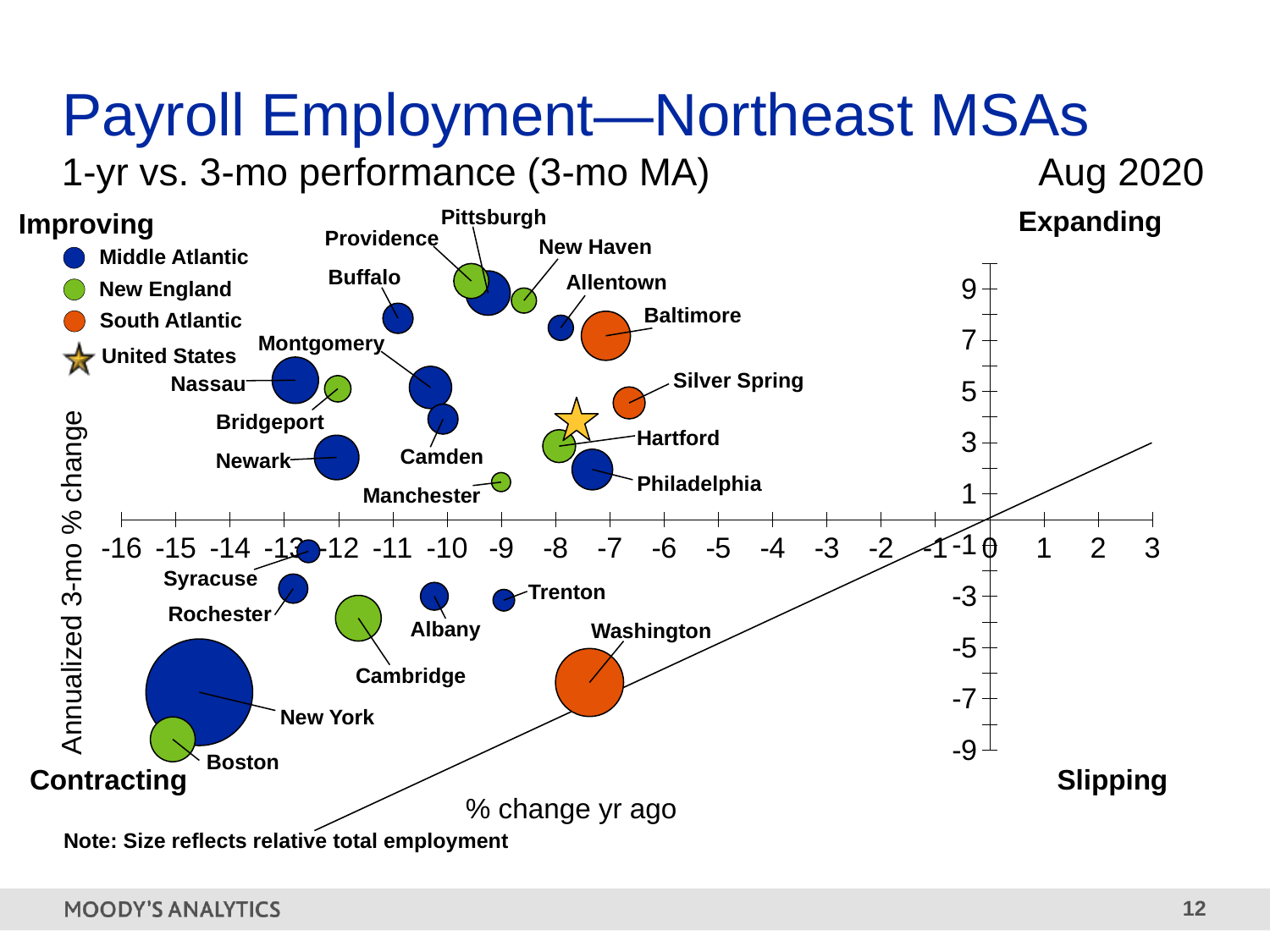
Is the annualized 3-mo % change for Baltimore greater or less than 5? greater Which MSA has the lowest annualized 3-mo % change? Boston Which has the lower % change yr ago, New York or Philadelphia? New York What kind of chart is shown on the slide? Bubble chart What is the title of the chart? Payroll Employment—Northeast MSAs How many entries does the legend list? 4 Is the % change yr ago for Washington greater or less than -10? greater Which has the higher annualized 3-mo % change, Baltimore or Washington? Baltimore Is the annualized 3-mo % change for Cambridge greater or less than -1? less